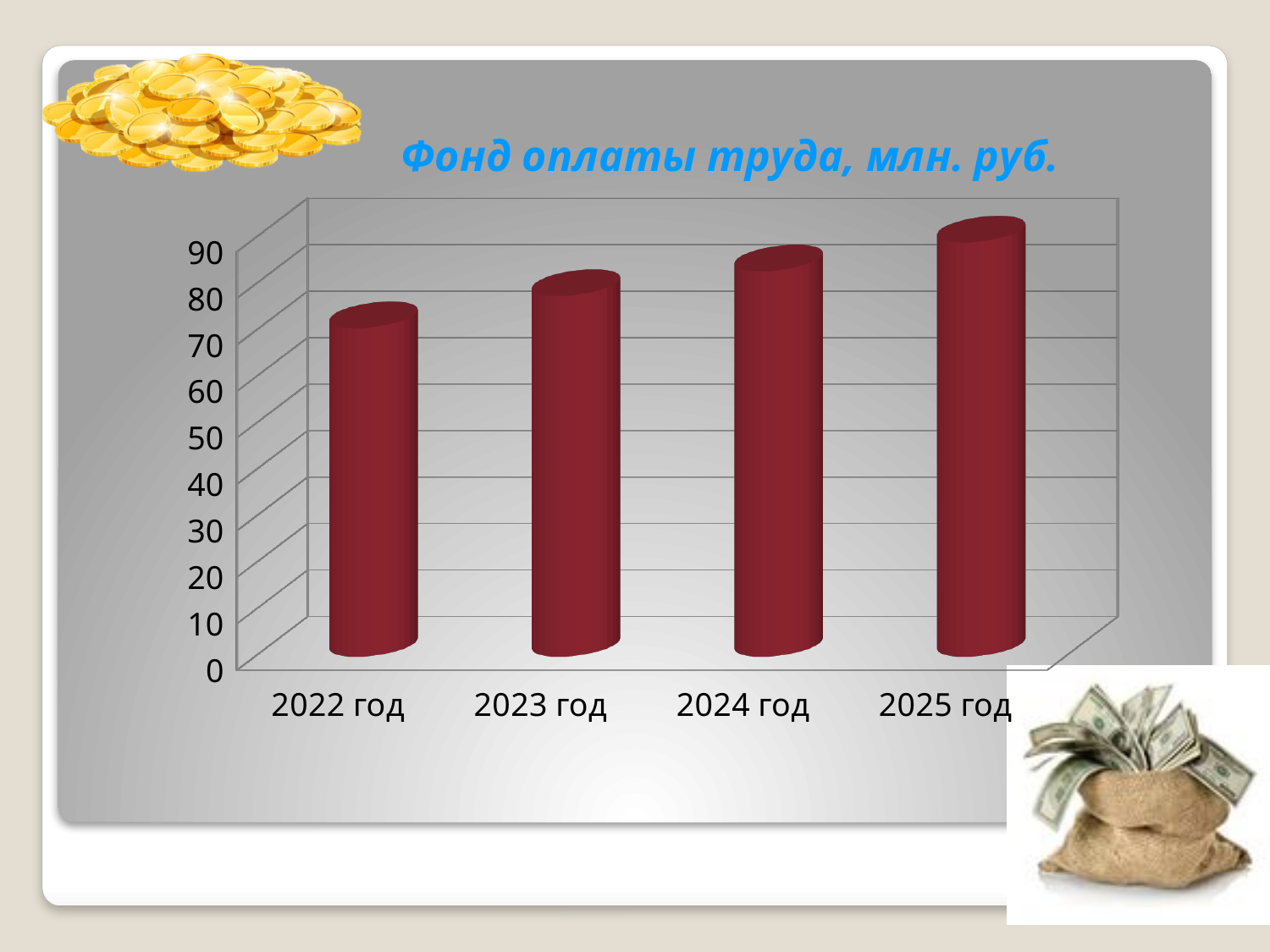
Do the values rise or fall from 2022 год to 2025 год? rise Which is larger, the value for 2023 год or the value for 2024 год? 2024 год How many years (categories) are shown on the x axis? 4 Which is larger, the value for 2022 год or the value for 2025 год? 2025 год Which year has the highest value? 2025 год Which year has the lowest value? 2022 год What is the title of the chart? Фонд оплаты труда, млн. руб. Is the value for 2022 год greater or less than 80? less Is the value for 2022 год greater or less than 60? greater What kind of chart is shown on the slide? bar chart Is the value for 2025 год greater or less than 80? greater